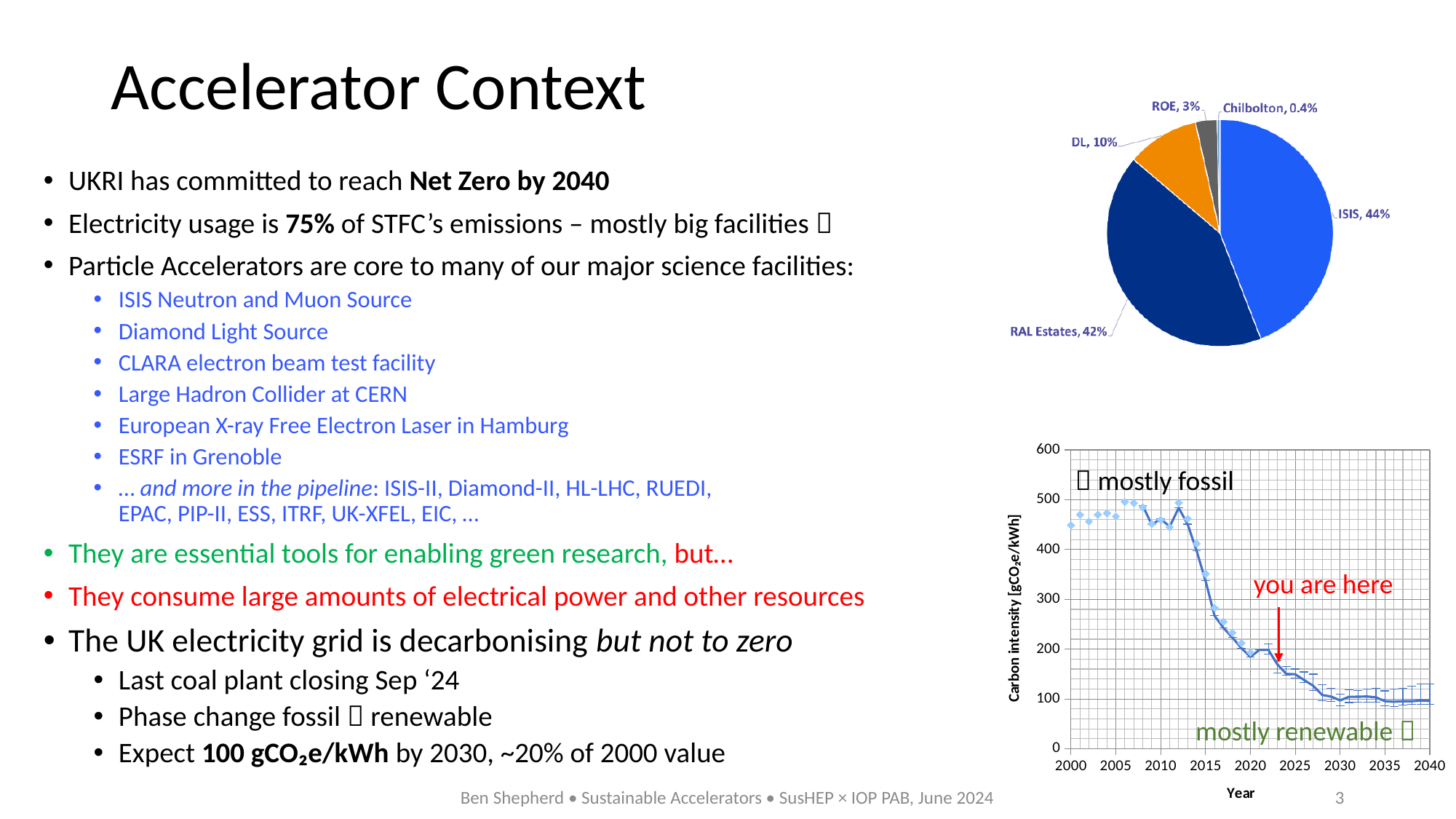
In the pie chart at the top right, how many slices are labelled? 5 In the pie chart at the top right, which slice is the smallest? Chilbolton In the pie chart at the top right, which slice is the largest? ISIS In the pie chart at the top right, what share does ISIS have? 44% In the line chart at the bottom right, is the carbon intensity value for 2005 greater or less than 400? greater In the line chart at the bottom right, does carbon intensity rise or fall between 2010 and 2030? Fall In the pie chart at the top right, what share does DL have? 10% In the pie chart at the top right, what is the difference in percentage points between the ISIS and RAL Estates shares? 2 percentage points In the pie chart at the top right, which is larger, the DL share or the ROE share? DL In the pie chart at the top right, what share does RAL Estates have? 42% What kind of chart is shown at the bottom right of the slide? Line chart In the line chart at the bottom right, what is the label on the y axis? Carbon intensity [gCO₂e/kWh]